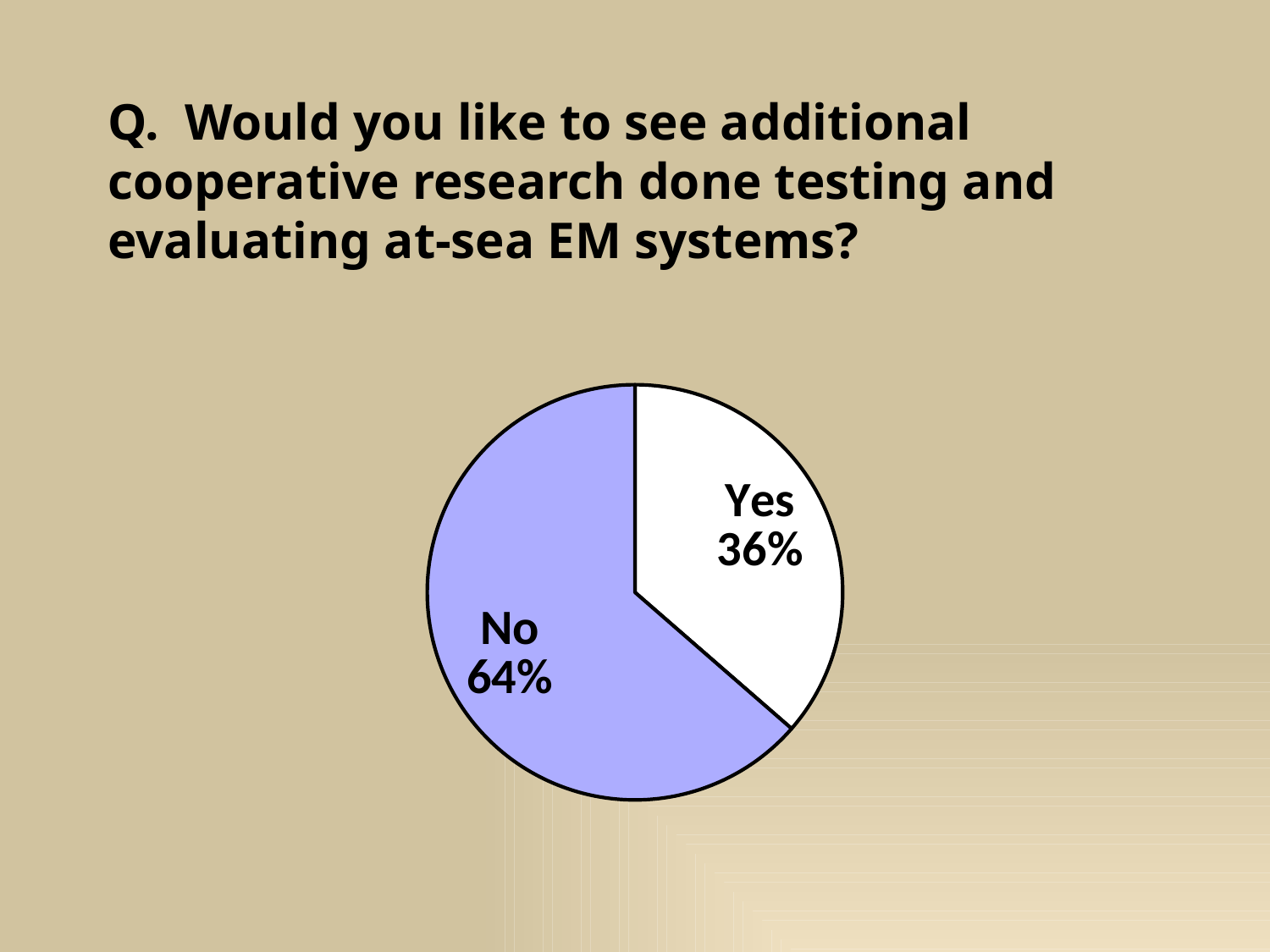
What colour is the No slice? light purple What percentage of respondents answered No? 64% Which response has the largest share of the pie? No How many slices does the pie chart have? 2 Which slice is larger, Yes or No? No What colour is the Yes slice? white What is the difference in percentage points between the No and Yes slices? 28 Which response has the smallest share of the pie? Yes What percentage of respondents answered Yes? 36% What kind of chart is shown on the slide? pie chart What share of the pie does the No slice represent? 64%